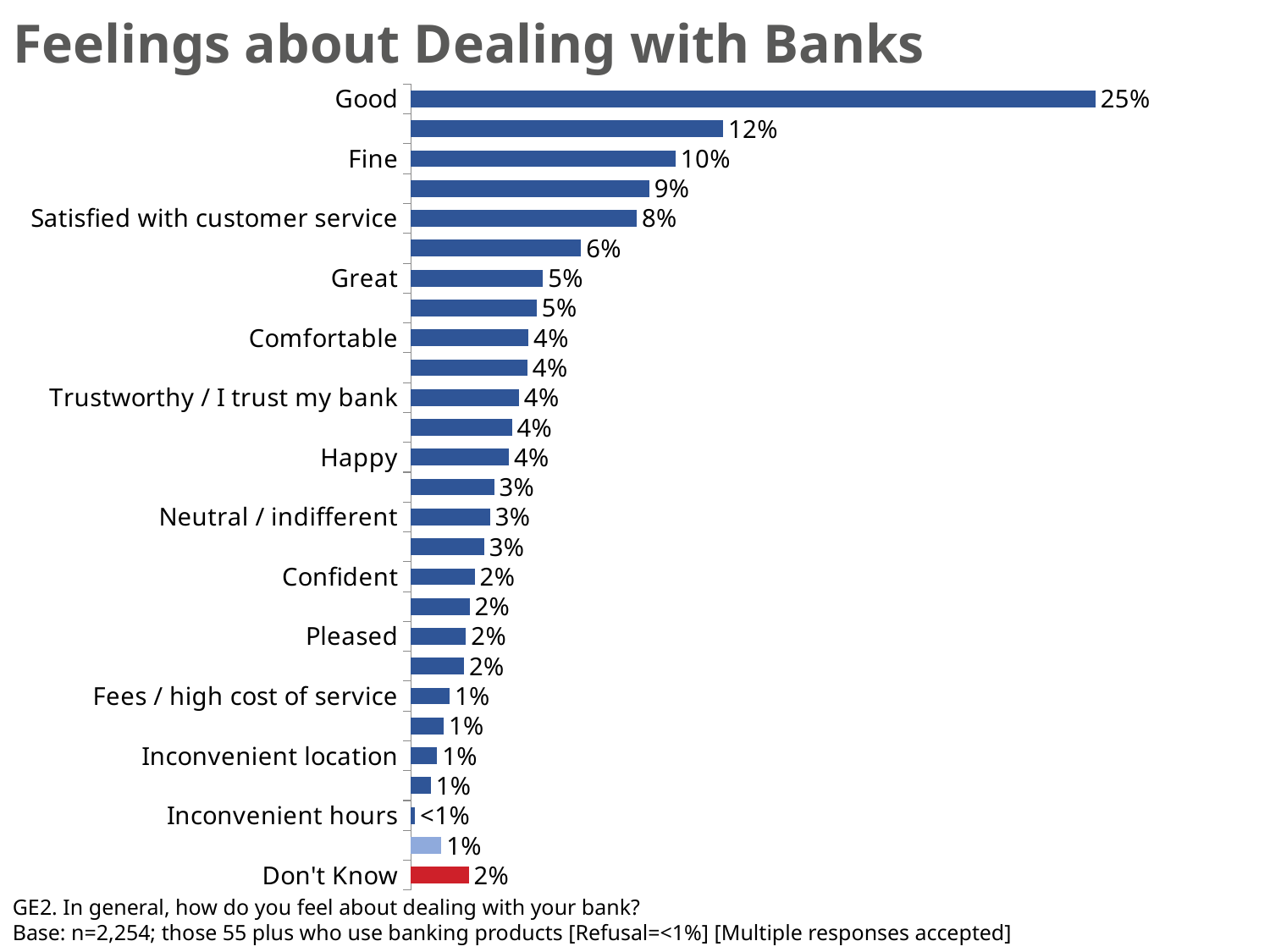
What is the difference between the percentages for "Good" and "Fine"? 15% Which has a larger value, "Great" or "Comfortable"? Great What percentage is shown for "Don't Know"? 2% What colour is the bar for "Don't Know"? Red What type of chart is shown on the slide? Bar chart What percentage of respondents said they feel "Good" about dealing with their bank? 25% What value is shown for "Inconvenient hours"? <1% What is the title of the chart? Feelings about Dealing with Banks What is the value for "Great"? 5% Which feeling has the highest percentage in the chart? Good What percentage is shown for "Satisfied with customer service"? 8% What is the value shown for "Fine"? 10%